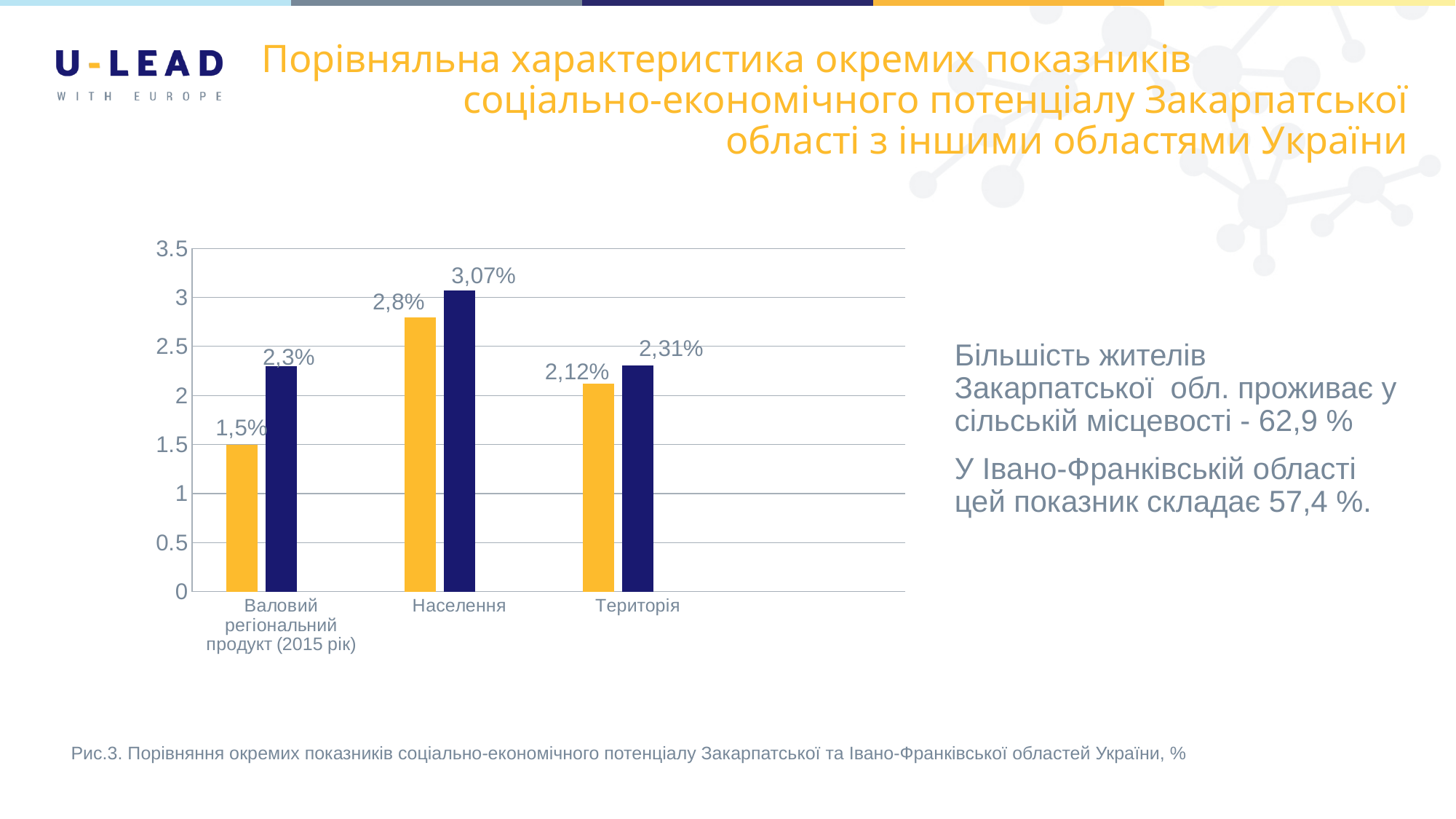
What is the value of the yellow bar for Валовий регіональний продукт (2015 рік)? 1,5% What is the value of the dark blue bar for Територія? 2,31% Is the value of the yellow bar for Територія greater or less than 2.5? less Which category has the lowest bar in the chart? Валовий регіональний продукт (2015 рік) What is the difference between the dark blue bar and the yellow bar for Валовий регіональний продукт (2015 рік)? 0,8% Which category has the highest bar in the chart? Населення Which is larger for Територія: the yellow bar or the dark blue bar? the dark blue bar What is the value of the dark blue bar for Населення? 3,07% How many categories are shown on the x axis of the chart? 3 What kind of chart is shown on the slide? bar chart What is the value of the yellow bar for Населення? 2,8% What is the highest value shown on the y axis of the chart? 3.5